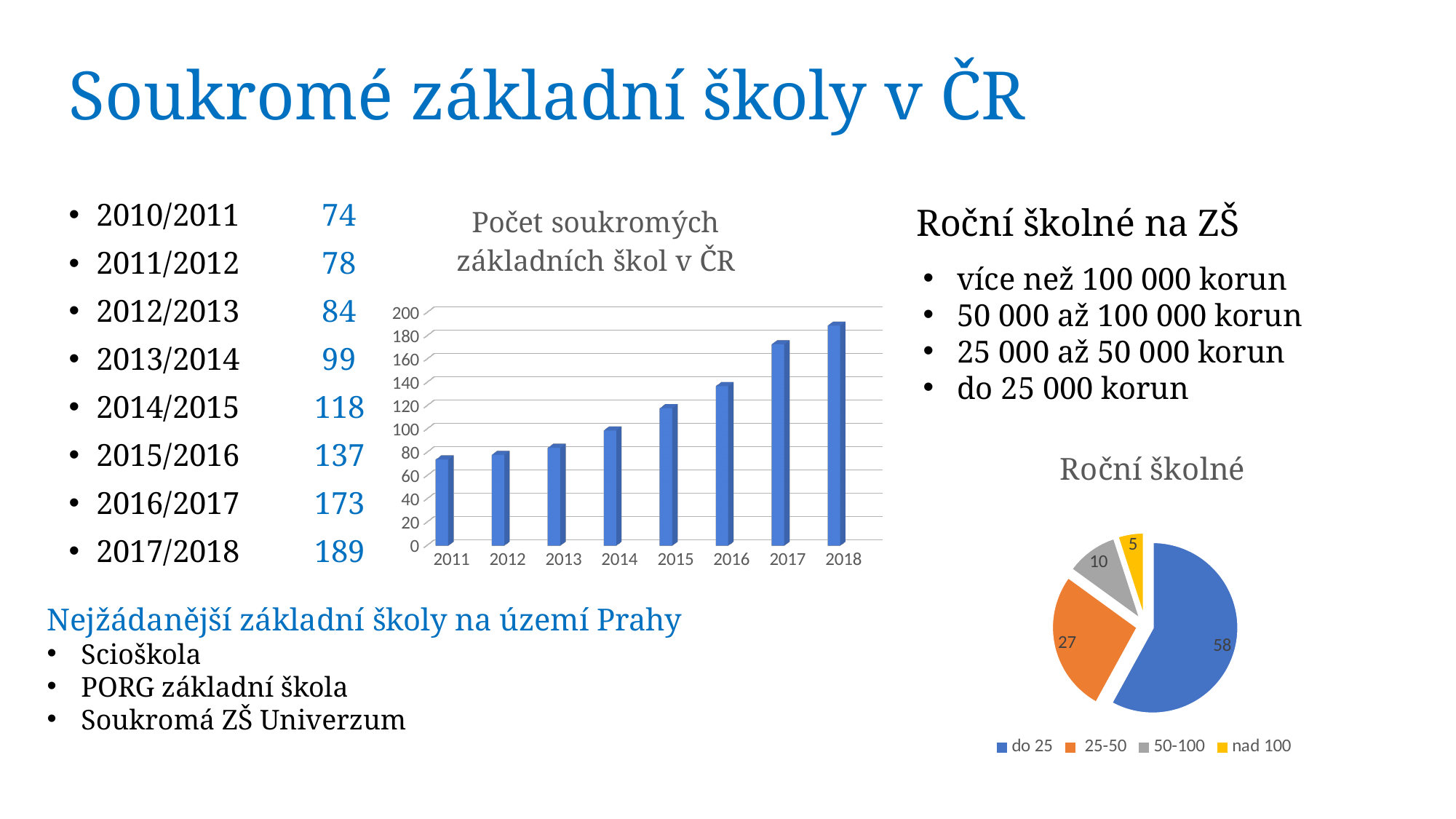
What kind of chart is 'Počet soukromých základních škol v ČR'? bar chart In the chart 'Počet soukromých základních škol v ČR', do the values rise or fall from 2011 to 2018? rise In the pie chart 'Roční školné', what is the difference between the values for 'do 25' and '25-50'? 31 In the pie chart 'Roční školné', what is the value for 'do 25'? 58 In the chart 'Počet soukromých základních škol v ČR', how many years are shown on the x axis? 8 In the chart 'Počet soukromých základních škol v ČR', is the value for 2018 greater or less than 180? greater In the chart 'Počet soukromých základních škol v ČR', is the value for 2011 greater or less than 80? less In the chart 'Počet soukromých základních škol v ČR', is the value for 2017 greater or less than 160? greater In the pie chart 'Roční školné', which category has the smallest slice? nad 100 In the chart 'Počet soukromých základních škol v ČR', which year has the lowest bar? 2011 In the chart 'Počet soukromých základních škol v ČR', which year has the highest bar? 2018 What kind of chart is 'Roční školné'? pie chart